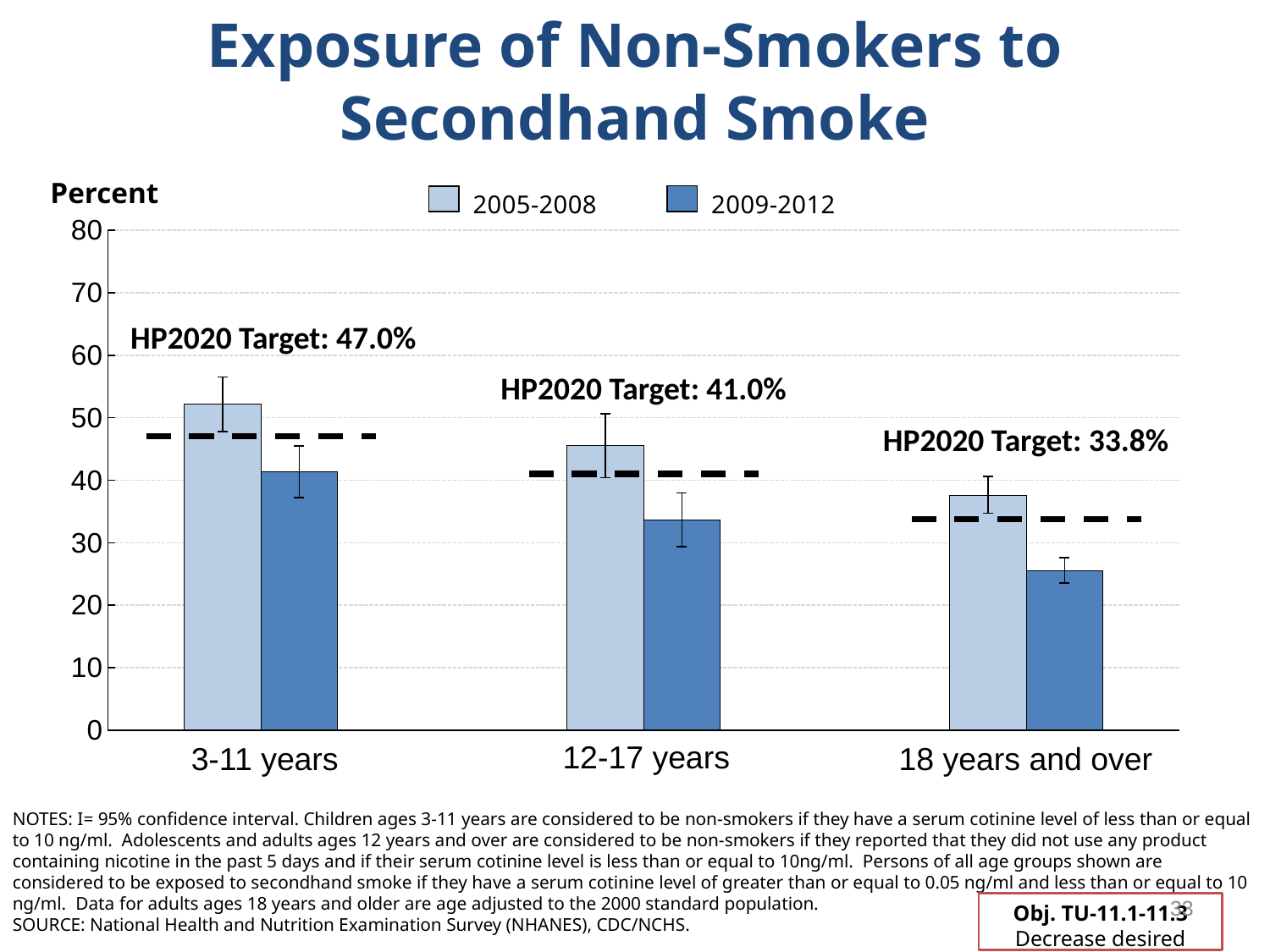
What is the HP2020 Target for the 12-17 years age group? 41.0% What is the difference between the HP2020 Target for 3-11 years and the HP2020 Target for 18 years and over? 13.2 percentage points How many age groups are shown on the x axis? 3 Is the 2005-2008 value for 3-11 years greater or less than 50? greater What is the HP2020 Target for the 18 years and over age group? 33.8% How many series does the legend list? 2 What are the two time periods listed in the legend? 2005-2008 and 2009-2012 What is the HP2020 Target for the 3-11 years age group? 47.0% Which age group has the lowest 2009-2012 value? 18 years and over Is the 2009-2012 value for 18 years and over greater or less than 30? less What kind of chart is shown on the slide? bar chart Which age group has the highest 2005-2008 value? 3-11 years